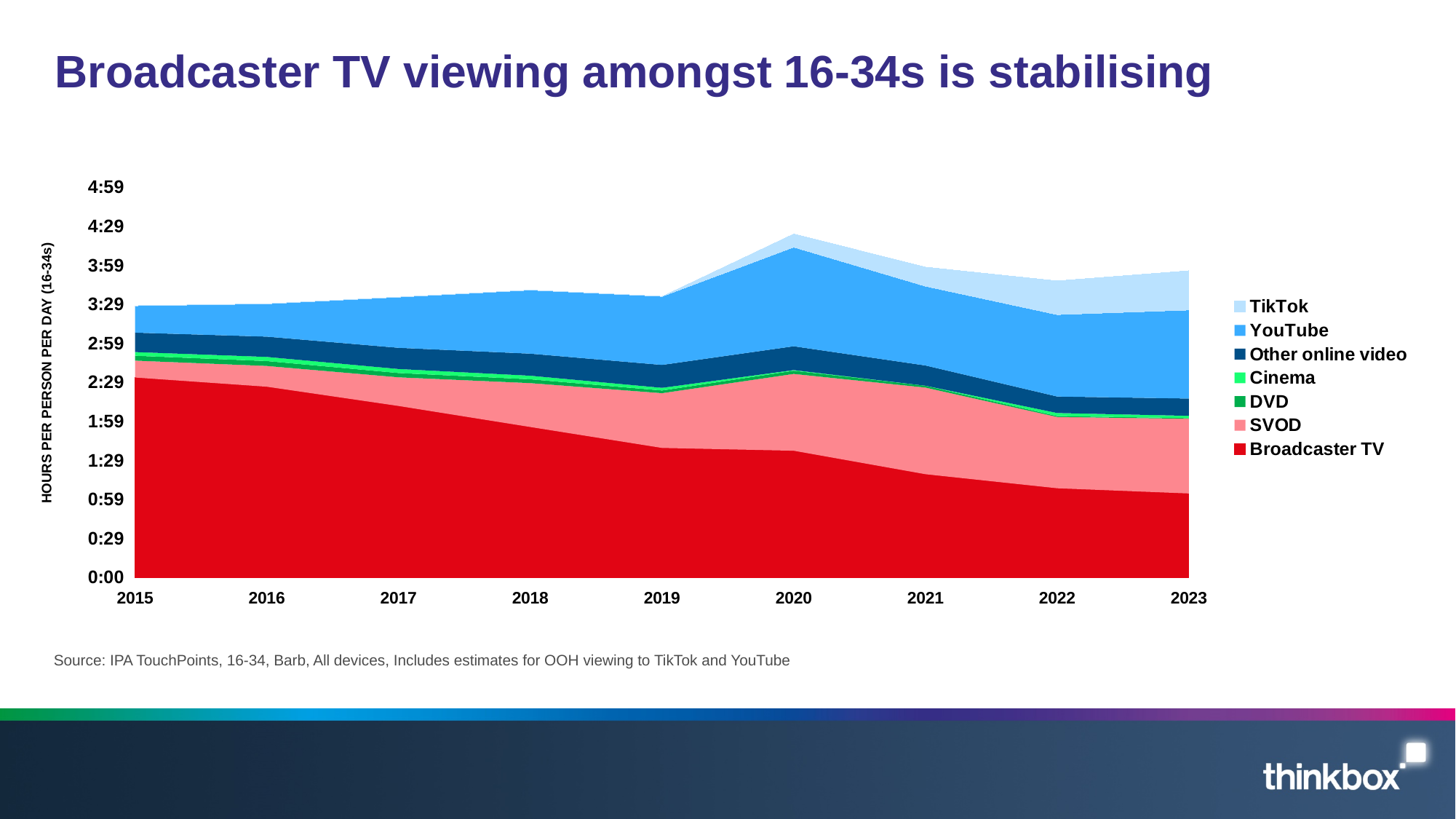
Which series takes up the largest share of viewing in 2015? Broadcaster TV Is the Broadcaster TV value in 2015 greater or less than 1:59? greater Is the total stacked value in 2015 greater or less than 3:59? less What is the label on the vertical axis? HOURS PER PERSON PER DAY (16-34s) How many series does the legend list? 7 What kind of chart is shown on the slide? Stacked area chart Is the total stacked value in 2020 greater or less than 3:59? greater Does Broadcaster TV viewing rise or fall from 2015 to 2023? Fall Which series is listed first (at the top) in the legend? TikTok In which year is the total stacked viewing time highest? 2020 How many years are plotted along the x axis? 9